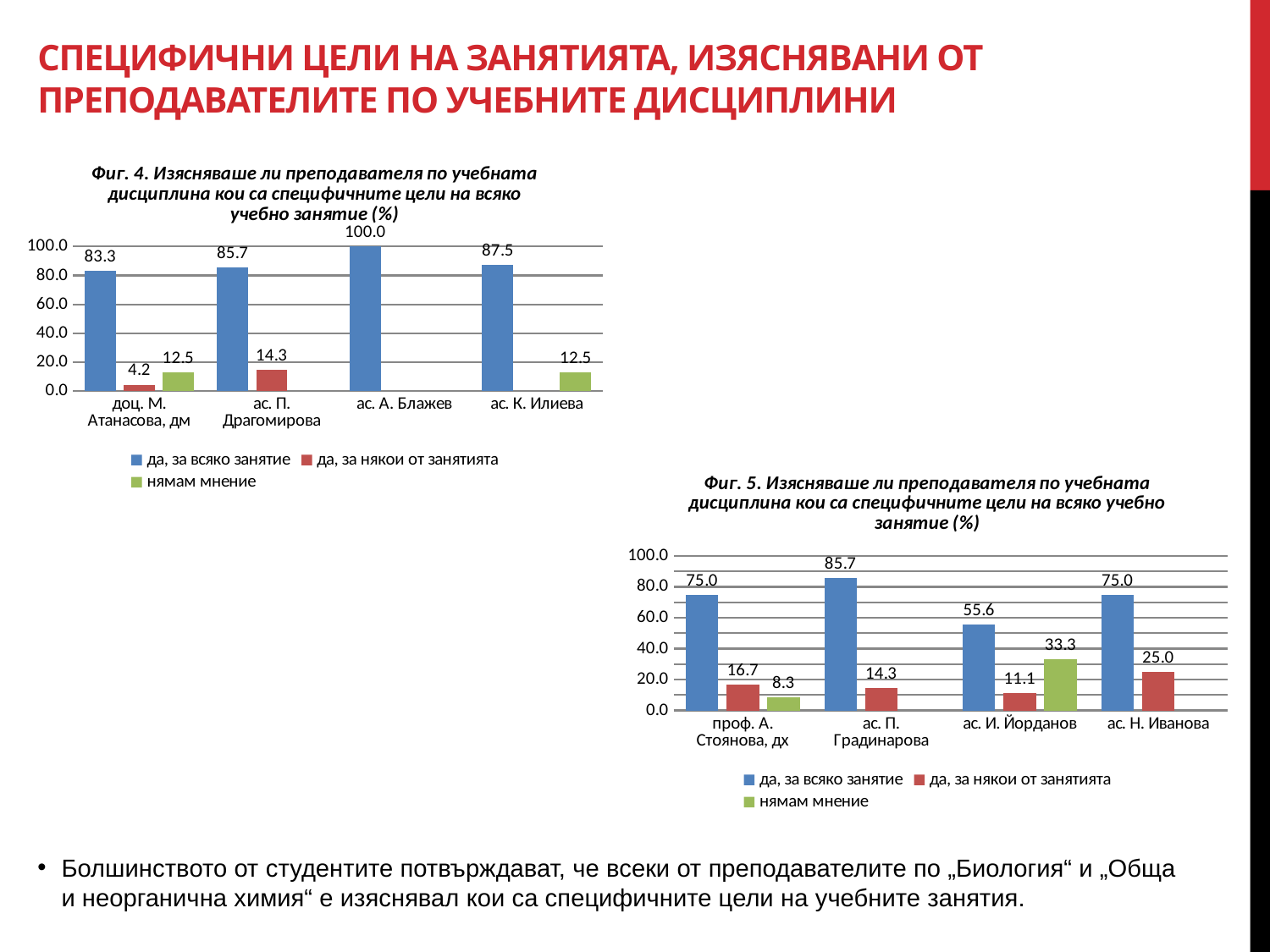
In Фиг. 5, which is larger: the "да, за всяко занятие" value for ас. П. Градинарова or for проф. А. Стоянова, дх? ас. П. Градинарова In Фиг. 5, how many lecturers are shown on the x axis? 4 In Фиг. 5, what is the value of "нямам мнение" for ас. И. Йорданов? 33.3 In Фиг. 5, what is the difference between the "да, за всяко занятие" values for ас. П. Градинарова and ас. И. Йорданов? 30.1 In Фиг. 4, what is the value of "да, за всяко занятие" for ас. А. Блажев? 100.0 In Фиг. 4, which lecturer has the highest value for "да, за всяко занятие"? ас. А. Блажев In Фиг. 4, how many series does the legend list? 3 In Фиг. 4, what is the value of "да, за някои от занятията" for доц. М. Атанасова, дм? 4.2 In Фиг. 4, what is the difference between the "да, за всяко занятие" values for ас. К. Илиева and доц. М. Атанасова, дм? 4.2 In Фиг. 5, which lecturer has the lowest value for "да, за всяко занятие"? ас. И. Йорданов In Фиг. 5, what is the value of "да, за някои от занятията" for ас. Н. Иванова? 25.0 What type of chart is Фиг. 5? Bar chart